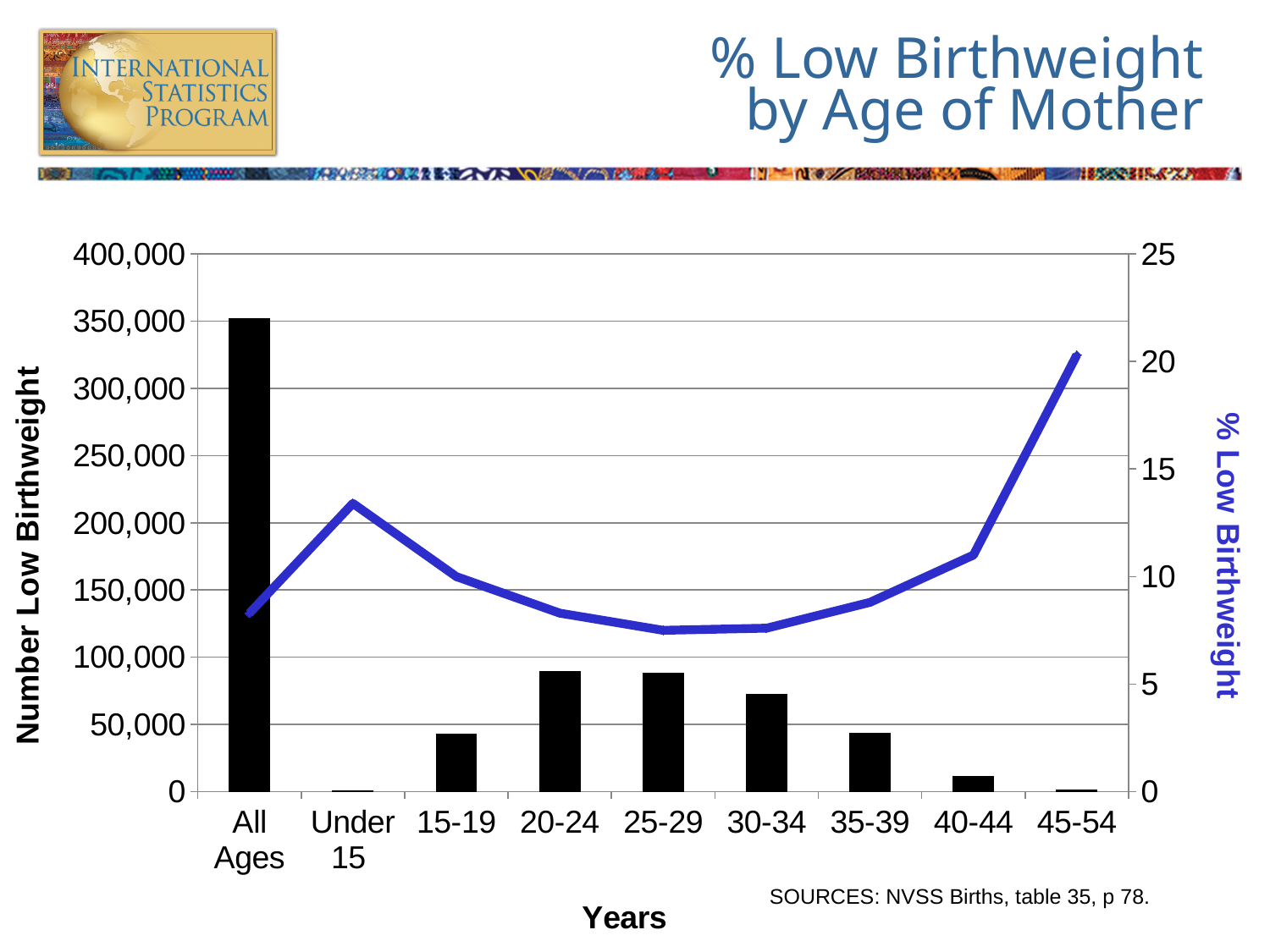
Which has the higher % Low Birthweight value, Under 15 or 40-44? Under 15 Is the % Low Birthweight value for 45-54 greater or less than 15? greater What kind of chart is shown on the slide? A combined bar and line chart Which has the taller Number Low Birthweight bar, 20-24 or 30-34? 20-24 Is the % Low Birthweight value for 25-29 greater or less than 10? less At which age category does the % Low Birthweight line reach its highest point? 45-54 Is the Number Low Birthweight bar for 20-24 greater or less than 100,000? less Does the % Low Birthweight line rise or fall from 25-29 to 45-54? rise Which category has the tallest bar for Number Low Birthweight? All Ages How many age categories are shown on the x axis of the chart? 9 What is the title of the chart on the slide? % Low Birthweight by Age of Mother